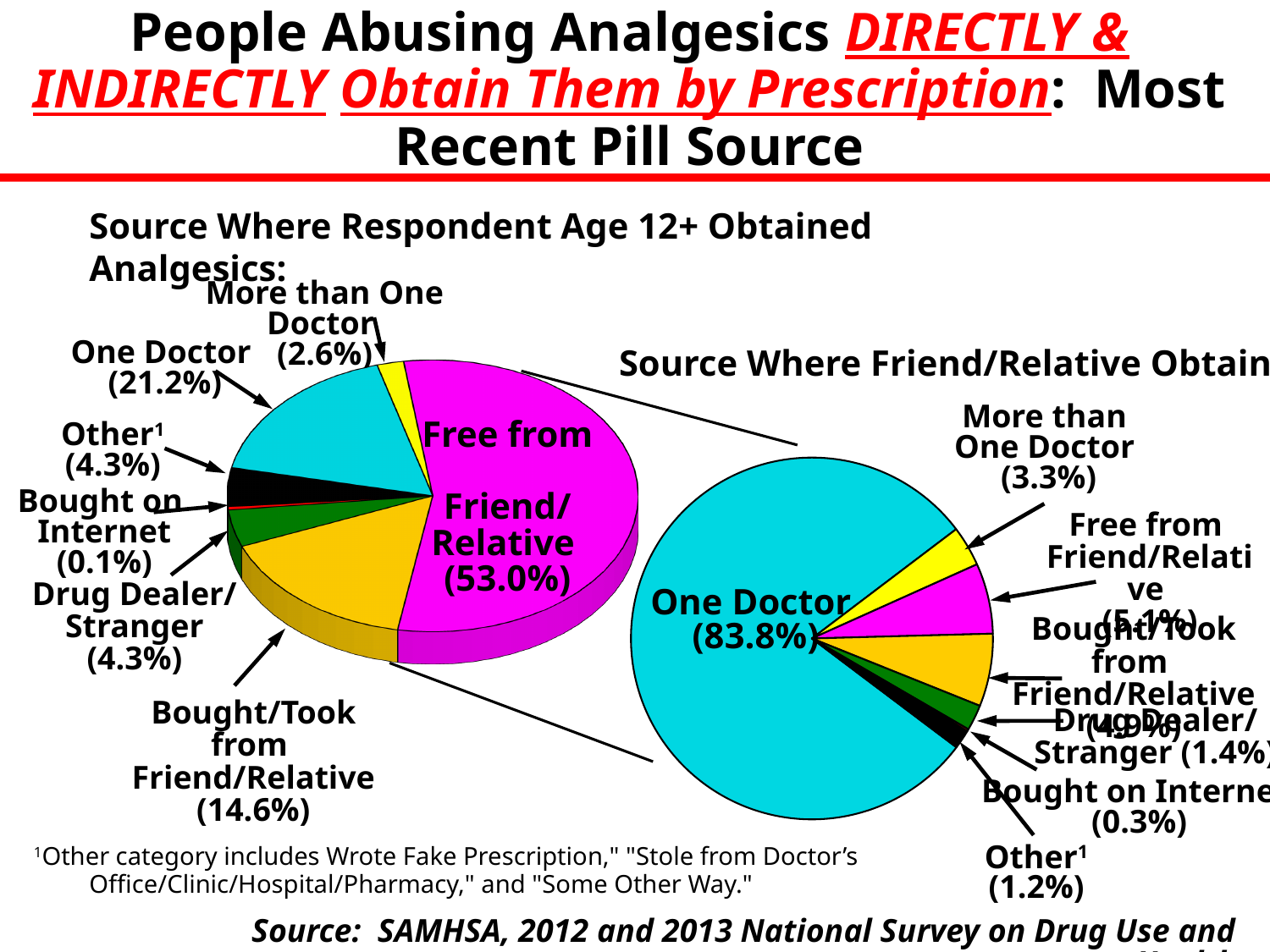
In the right pie chart (Source Where Friend/Relative Obtained), what percentage is shown for Drug Dealer/Stranger? 1.4% In the right pie chart (Source Where Friend/Relative Obtained), what percentage is shown for More than One Doctor? 3.3% In the left pie chart (Source Where Respondent Age 12+ Obtained Analgesics), what is the difference in percentage points between One Doctor and More than One Doctor? 18.6 In the left pie chart (Source Where Respondent Age 12+ Obtained Analgesics), what percentage is shown for One Doctor? 21.2% In the left pie chart (Source Where Respondent Age 12+ Obtained Analgesics), which source has the largest share? Free from Friend/Relative In the left pie chart (Source Where Respondent Age 12+ Obtained Analgesics), what percentage is shown for Bought/Took from Friend/Relative? 14.6% In the left pie chart (Source Where Respondent Age 12+ Obtained Analgesics), what percentage is shown for Free from Friend/Relative? 53.0% In the right pie chart (Source Where Friend/Relative Obtained), which is larger: Bought on Internet or Other? Other In the left pie chart (Source Where Respondent Age 12+ Obtained Analgesics), which source has the smallest share? Bought on Internet In the right pie chart (Source Where Friend/Relative Obtained), what percentage is shown for One Doctor? 83.8% In the left pie chart (Source Where Respondent Age 12+ Obtained Analgesics), how many source categories are shown? 7 What type of chart is used on this slide? Pie chart